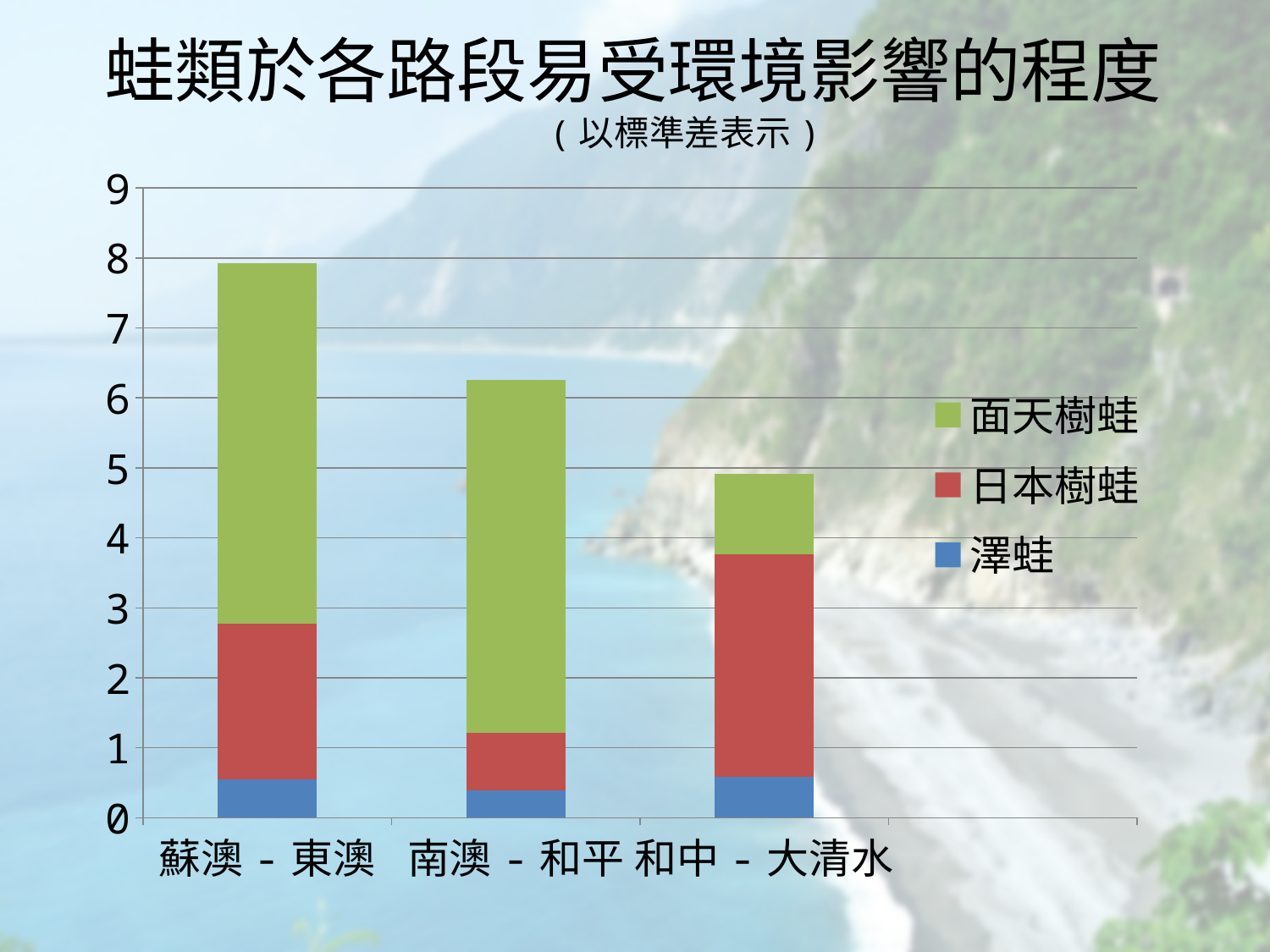
Which colour represents 澤蛙 in the legend? Blue Is the total value for 蘇澳－東澳 greater or less than 7? greater Which road section has the highest total bar? 蘇澳－東澳 How many road sections (categories) are shown on the x axis? 3 Do the total bar heights rise or fall from left to right across the road sections? Fall Is the 日本樹蛙 segment larger for 和中－大清水 or for 蘇澳－東澳? 和中－大清水 Is the total value for 南澳－和平 greater or less than 5? greater Which road section has the lowest total bar? 和中－大清水 How many series does the legend list? 3 What does the subtitle under the chart title say the values are expressed as? 以標準差表示 Is the total value for 和中－大清水 greater or less than 6? less What kind of chart is shown on the slide? Stacked bar chart